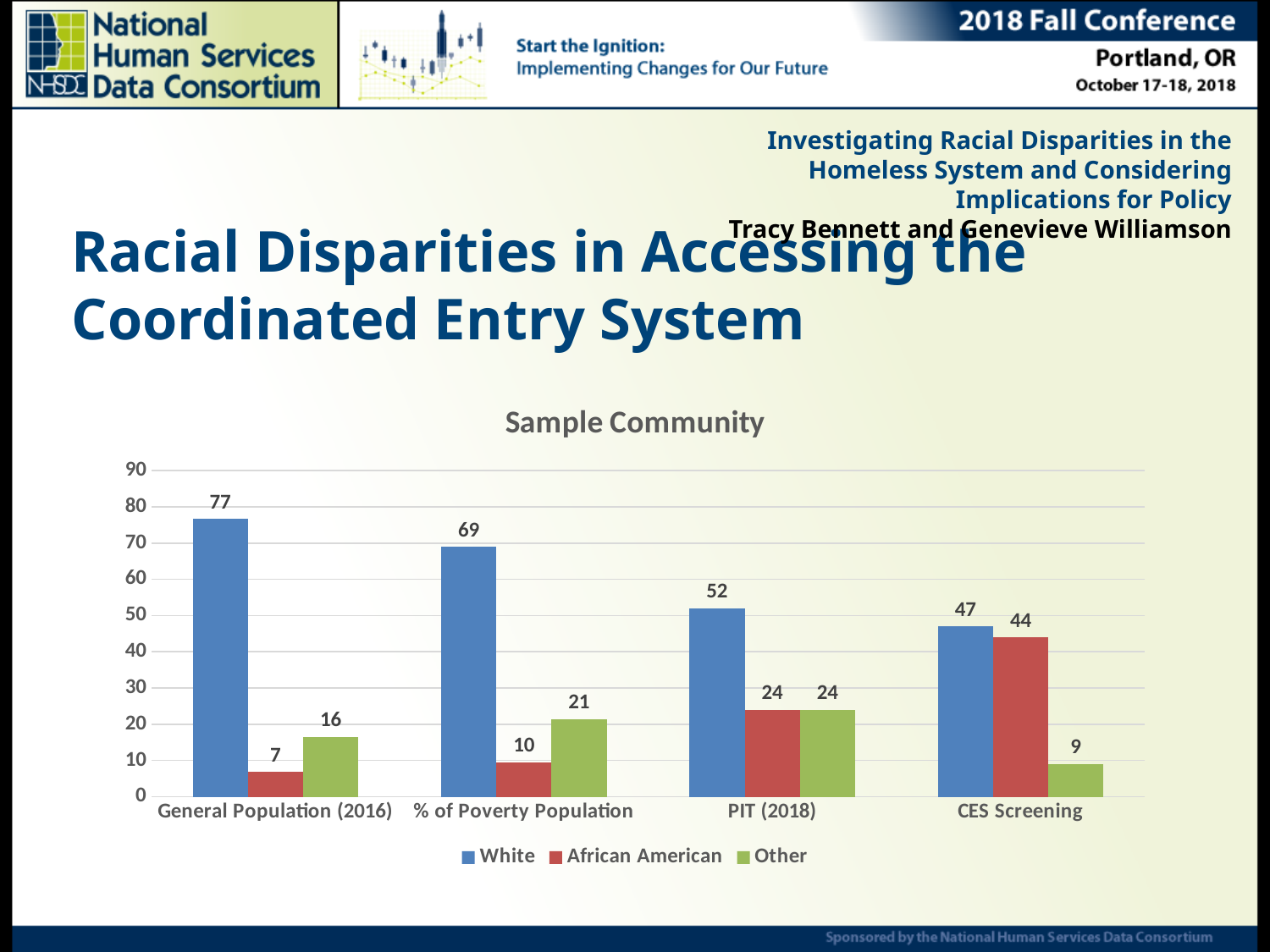
In which category is the White series highest? General Population (2016) How many categories are shown on the x axis? 4 What is the title of the chart? Sample Community What kind of chart is shown on the slide? Bar chart How many series does the legend list? 3 What is the difference between the White and African American values in the PIT (2018) category? 28 Which is larger in the CES Screening category, the White value or the Other value? White What is the value for Other in the % of Poverty Population category? 21 Do the White values rise or fall across the categories from left to right? Fall What is the value for White in the General Population (2016) category? 77 What is the value for African American in the CES Screening category? 44 In which category is the African American series lowest? General Population (2016)